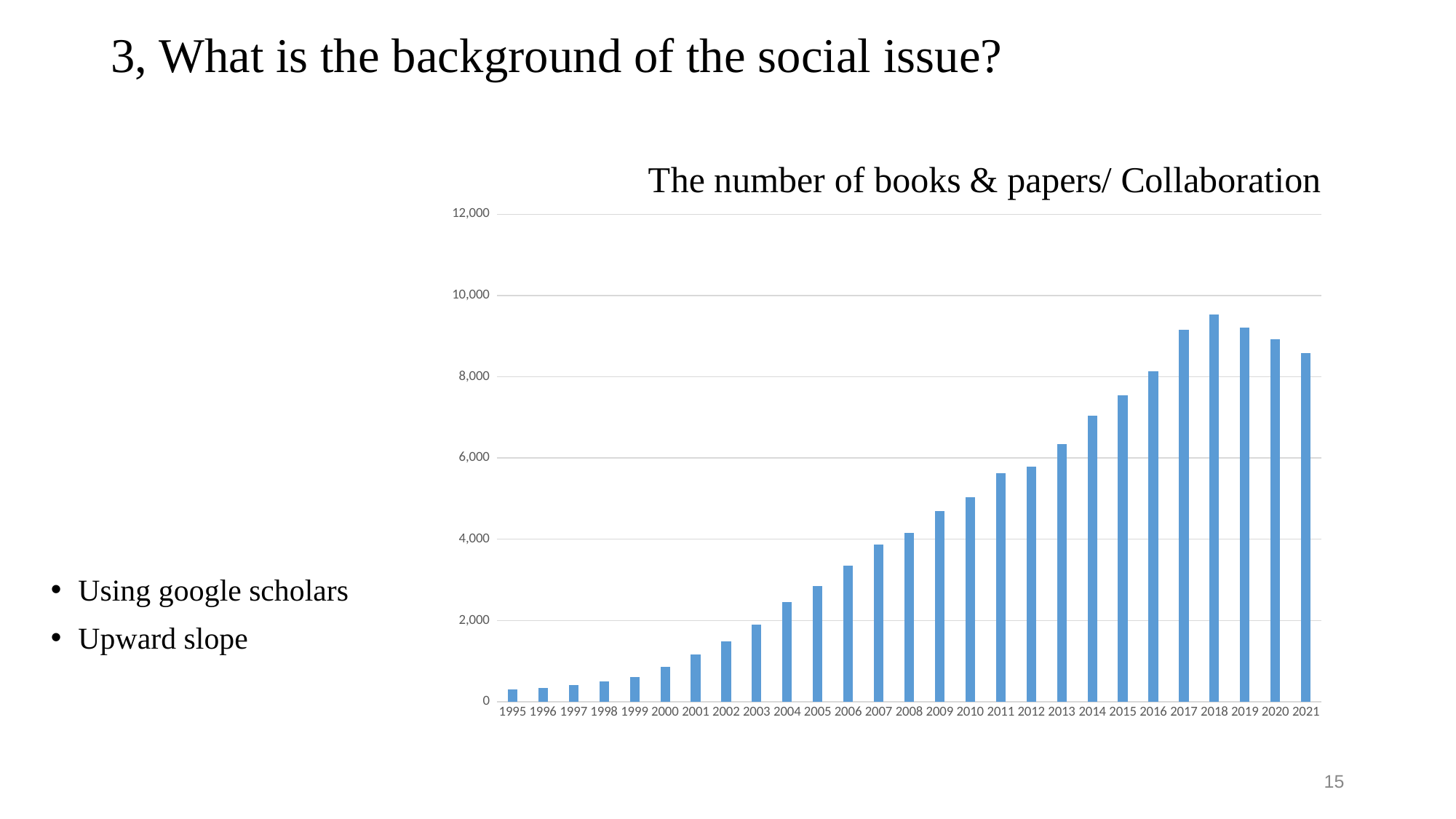
Which is larger, the value for 2005 or the value for 2012? 2012 Is the value for 2018 greater or less than 8,000? greater Which year has the highest bar in the chart? 2018 How many years are shown on the x axis of the chart? 27 Do the values generally rise or fall from 1995 to 2018? rise Which is larger, the value for 2017 or the value for 2021? 2017 Which year has the lowest bar in the chart? 1995 What kind of chart is shown on the slide? bar chart Is the value for 2010 greater or less than 6,000? less What is the title of the chart? The number of books & papers/ Collaboration